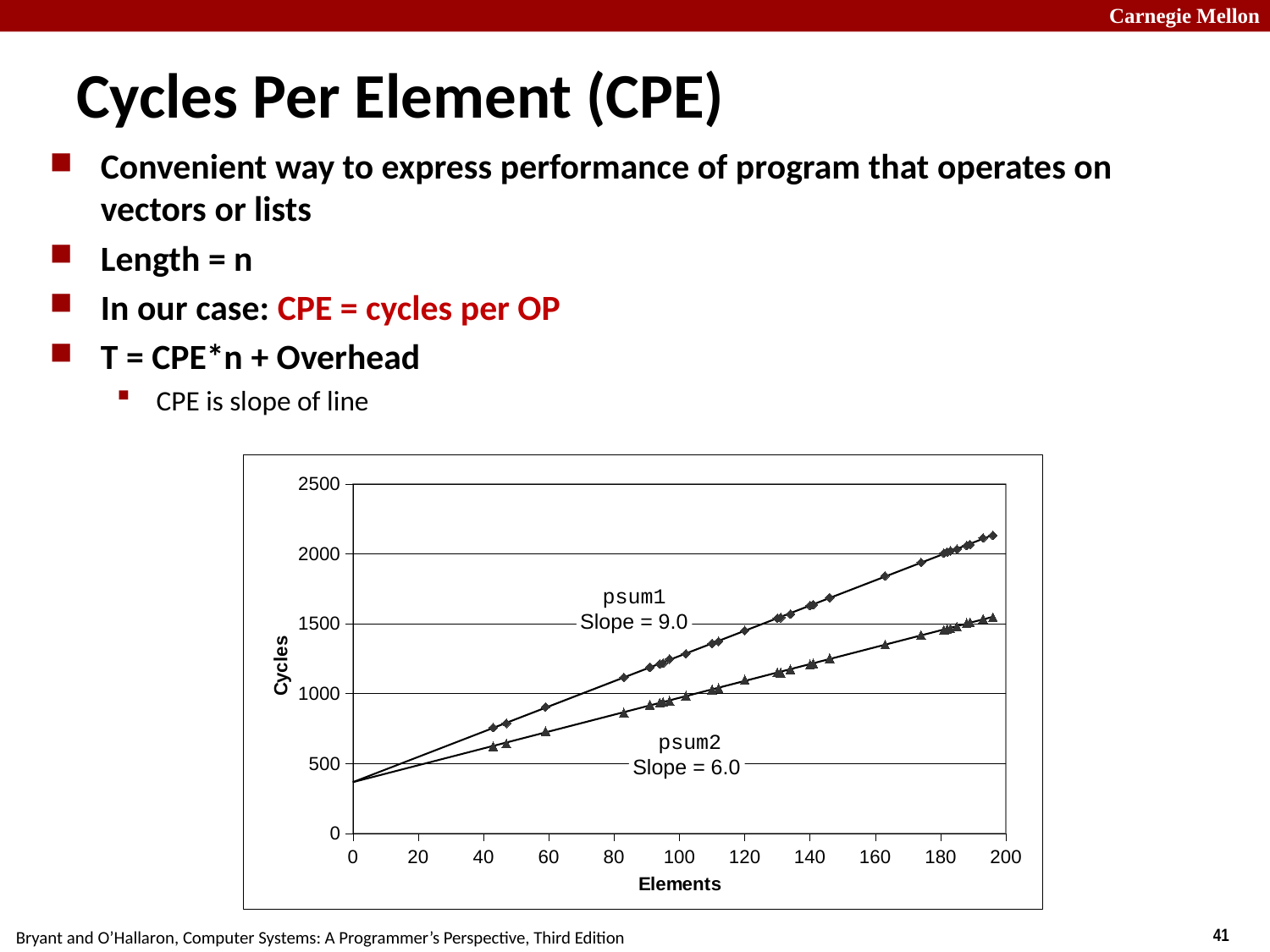
Which series has the steeper slope, psum1 or psum2? psum1 What is the label of the vertical axis of the chart? Cycles Do the cycles for psum1 rise or fall as the number of elements increases? rise What is the slope printed for the psum1 line? 9.0 What is the label of the horizontal axis of the chart? Elements What is the difference between the printed slopes of psum1 and psum2? 3.0 Is the value for psum1 at about 200 elements greater or less than 2000 cycles? greater What is the slope printed for the psum2 line? 6.0 How many series are plotted on the chart? 2 What kind of chart is shown on the slide? scatter chart with fitted lines Is the value for psum2 at about 160 elements greater or less than 1500 cycles? less